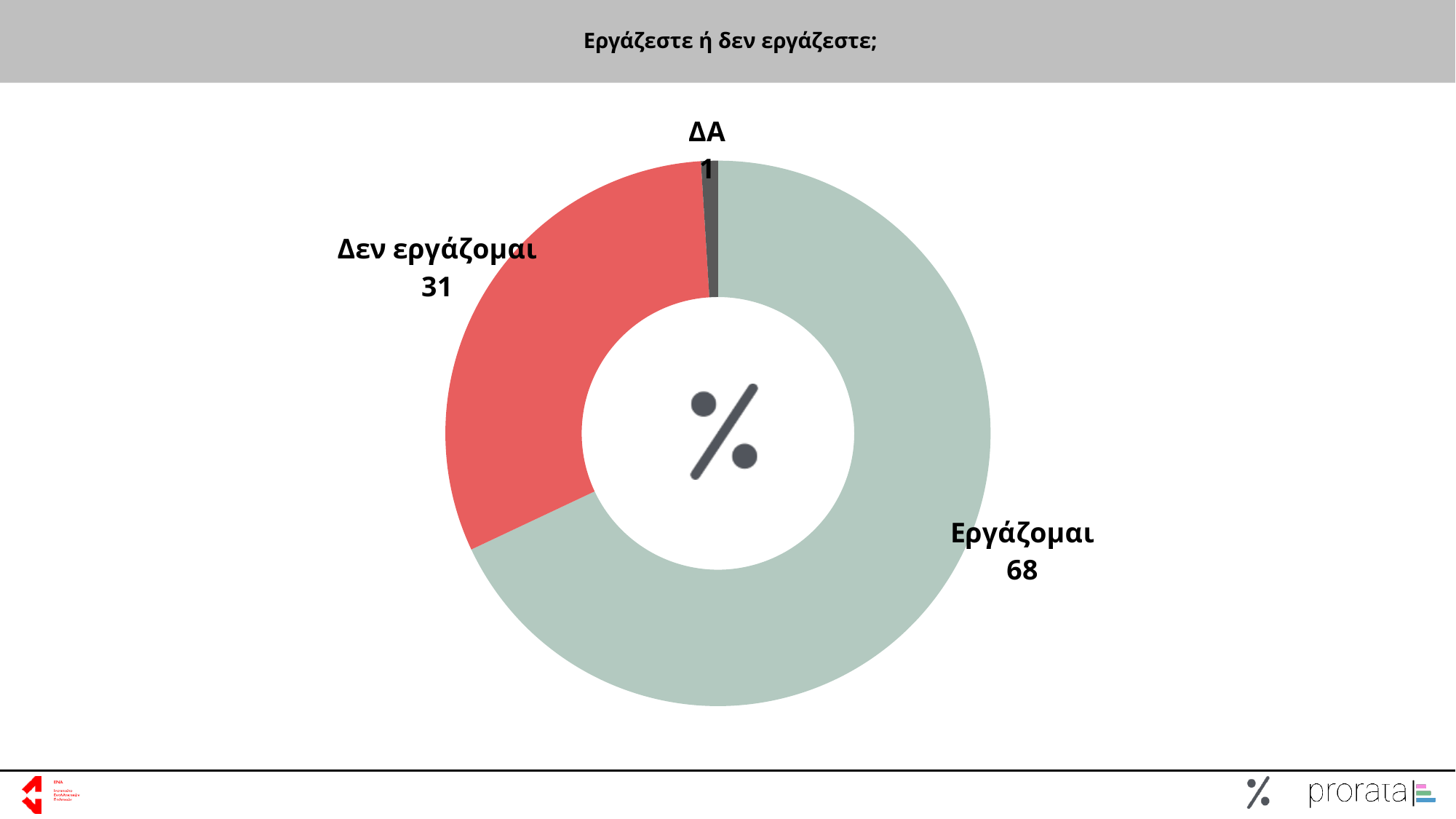
Which category has the highest value? Εργάζομαι What is the value for ΔΑ? 1 What kind of chart is shown on the slide? Pie chart (doughnut) What is the value for Εργάζομαι? 68 What is the total of the three values shown in the chart? 100 How many categories are shown in the chart? 3 What is the difference between the values for Εργάζομαι and Δεν εργάζομαι? 37 What colour is the Δεν εργάζομαι slice? Red Which is larger, Δεν εργάζομαι or ΔΑ? Δεν εργάζομαι What is the value for Δεν εργάζομαι? 31 What is the title of the chart? Εργάζεστε ή δεν εργάζεστε; Which category has the lowest value? ΔΑ